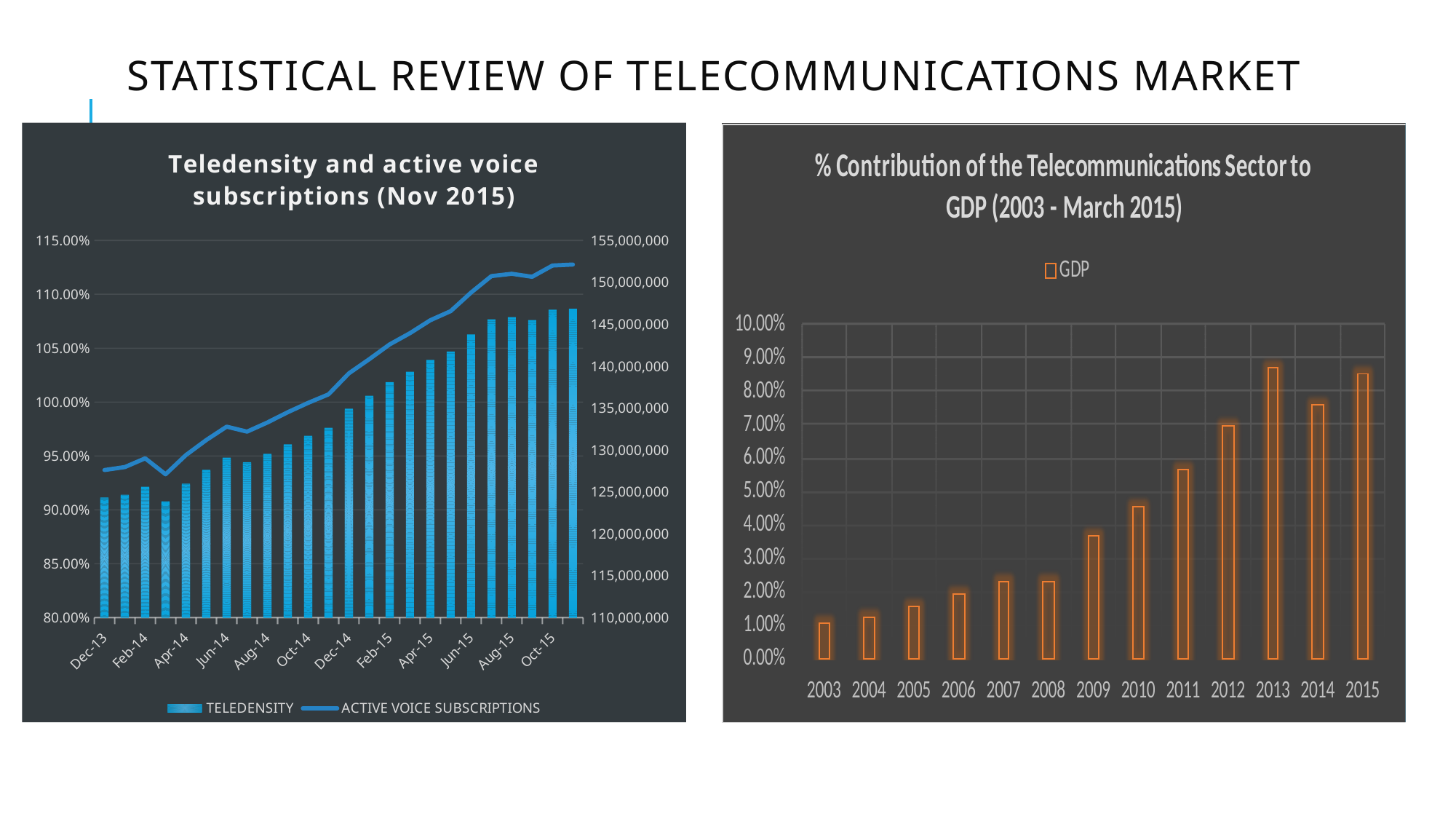
In the right chart, is the value for 2013 greater or less than 8.00%? greater In the right chart, which is larger, the value for 2010 or the value for 2009? 2010 In the right chart, which year has the lowest GDP contribution? 2003 In the left chart, is the teledensity value for Apr-14 greater or less than 95.00%? less In the left chart, which series is drawn as a line? ACTIVE VOICE SUBSCRIPTIONS In the left chart, is the teledensity value for Oct-15 greater or less than 105.00%? greater How many series does the legend of the left chart list? 2 What type of chart is the '% Contribution of the Telecommunications Sector to GDP (2003 - March 2015)' chart on the right? Bar chart What type of chart is the 'Teledensity and active voice subscriptions (Nov 2015)' chart on the left? Combination bar and line chart How many years are shown on the x axis of the right chart? 13 In the left chart, do active voice subscriptions generally rise or fall from Dec-13 to Oct-15? Rise